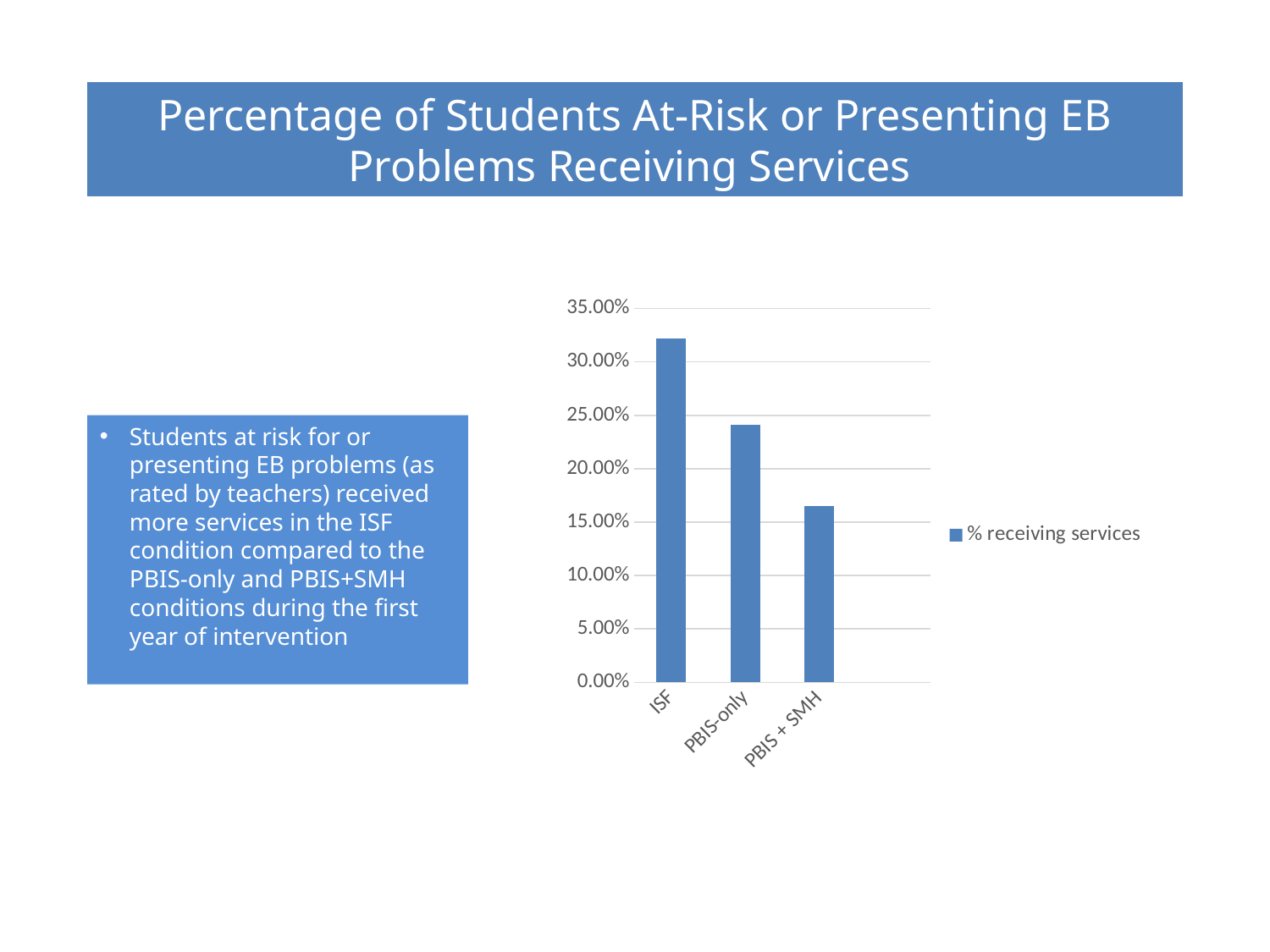
Which category has the highest percentage receiving services? ISF How many series does the chart legend list? 1 Is the value for ISF greater or less than 30.00%? greater How many categories are shown on the x axis of the chart? 3 Which is larger, the value for PBIS-only or the value for PBIS + SMH? PBIS-only Which category has the lowest percentage receiving services? PBIS + SMH Do the values rise or fall moving from ISF to PBIS + SMH along the x axis? fall What kind of chart is shown on the slide? bar chart Is the value for PBIS-only greater or less than 20.00%? greater Is the value for PBIS + SMH greater or less than 20.00%? less What is the series name shown in the chart legend? % receiving services Which is larger, the value for ISF or the value for PBIS-only? ISF